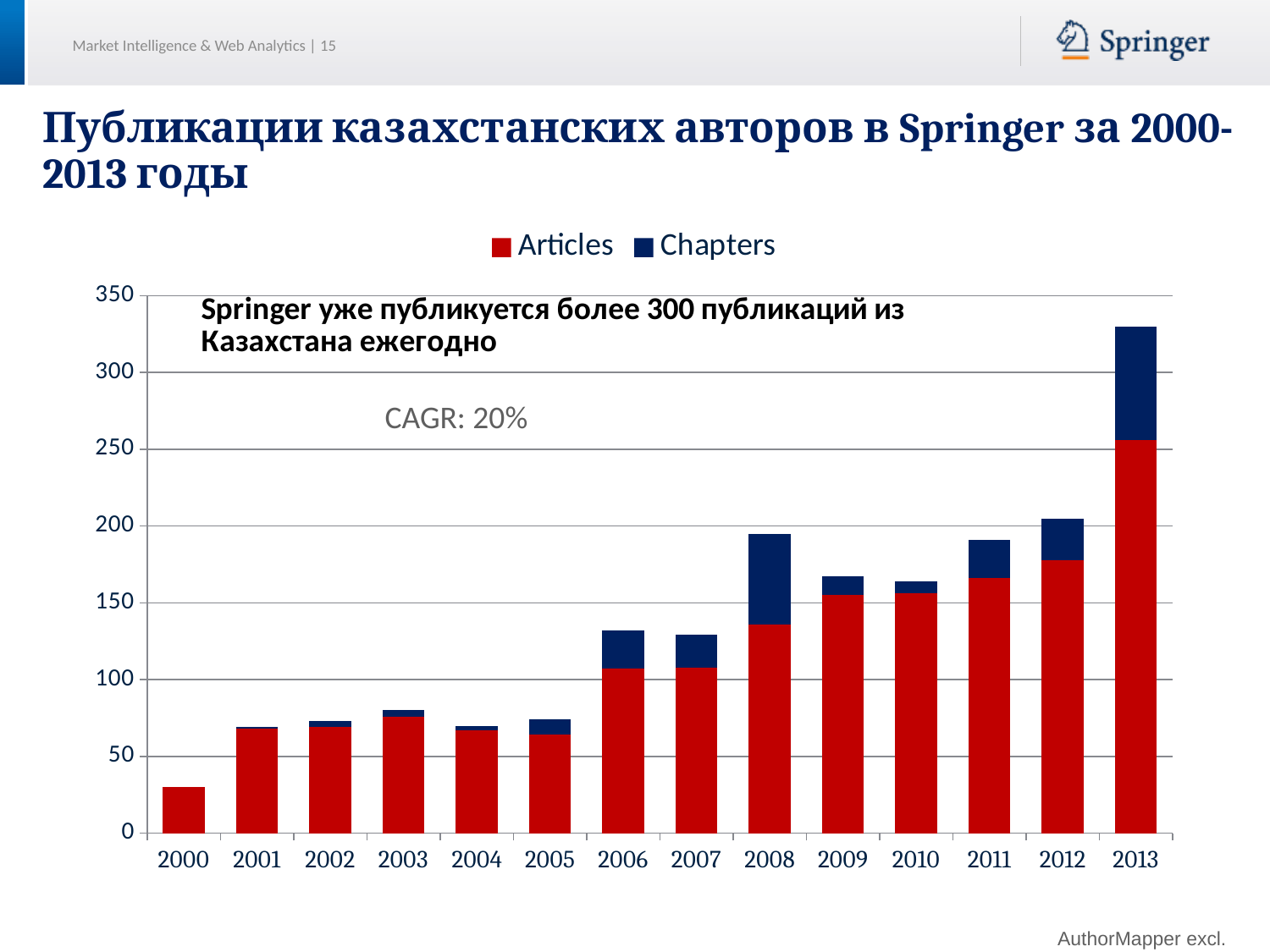
Do the total publication values generally rise or fall from 2000 to 2013? rise How many series does the chart legend list? 2 Is the total value for 2000 greater or less than 50? less Is the total value for 2013 greater or less than 300? greater Which year has the lowest total number of publications? 2000 Which colour represents the Chapters series in the chart? Dark blue Which year has a larger total, 2008 or 2009? 2008 Is the total value for 2003 greater or less than 100? less What kind of chart is shown on the slide? Stacked bar chart How many years are shown on the x axis of the chart? 14 Which year has the highest total number of publications? 2013